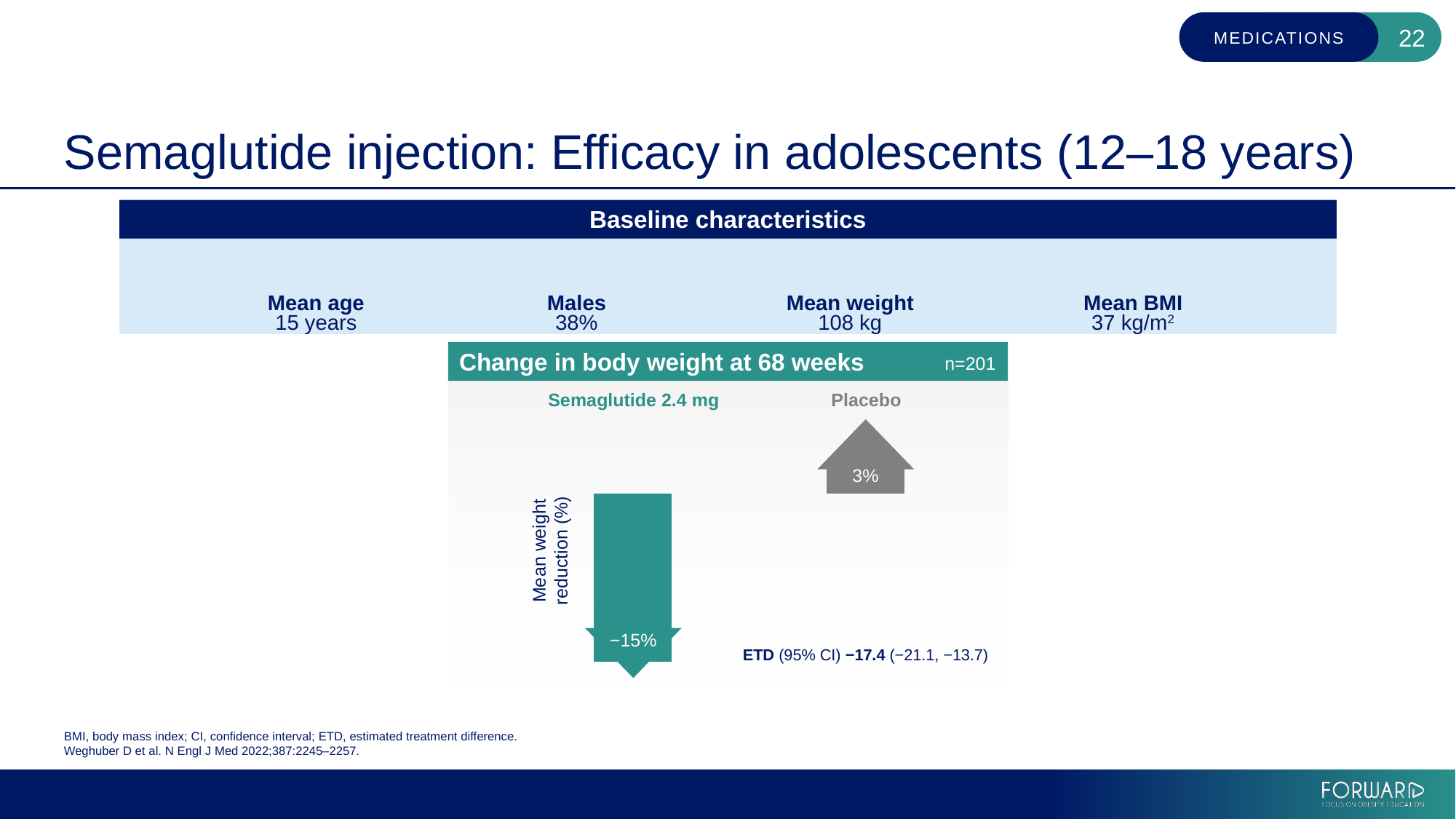
What is the label on the vertical axis of the 'Change in body weight at 68 weeks' chart? Mean weight reduction (%) What is the estimated treatment difference (ETD) shown in the 'Change in body weight at 68 weeks' chart? −17.4 In the 'Change in body weight at 68 weeks' chart, which group has the lowest (most negative) weight change value? Semaglutide 2.4 mg What is the sample size (n) shown in the header of the 'Change in body weight at 68 weeks' chart? n=201 In the 'Change in body weight at 68 weeks' chart, what is the mean weight change for Semaglutide 2.4 mg? −15% How many treatment groups are shown in the 'Change in body weight at 68 weeks' chart? 2 What is the 95% confidence interval for the ETD shown in the 'Change in body weight at 68 weeks' chart? (−21.1, −13.7) In the 'Change in body weight at 68 weeks' chart, what is the mean weight change for Placebo? 3% In the 'Change in body weight at 68 weeks' chart, which group shows the larger weight reduction? Semaglutide 2.4 mg In the 'Change in body weight at 68 weeks' chart, how many percentage points separate the Semaglutide 2.4 mg value (−15%) from the Placebo value (3%)? 18 percentage points In the 'Change in body weight at 68 weeks' chart, which direction does the Placebo arrow point? Up In the 'Change in body weight at 68 weeks' chart, which group has the highest weight change value? Placebo